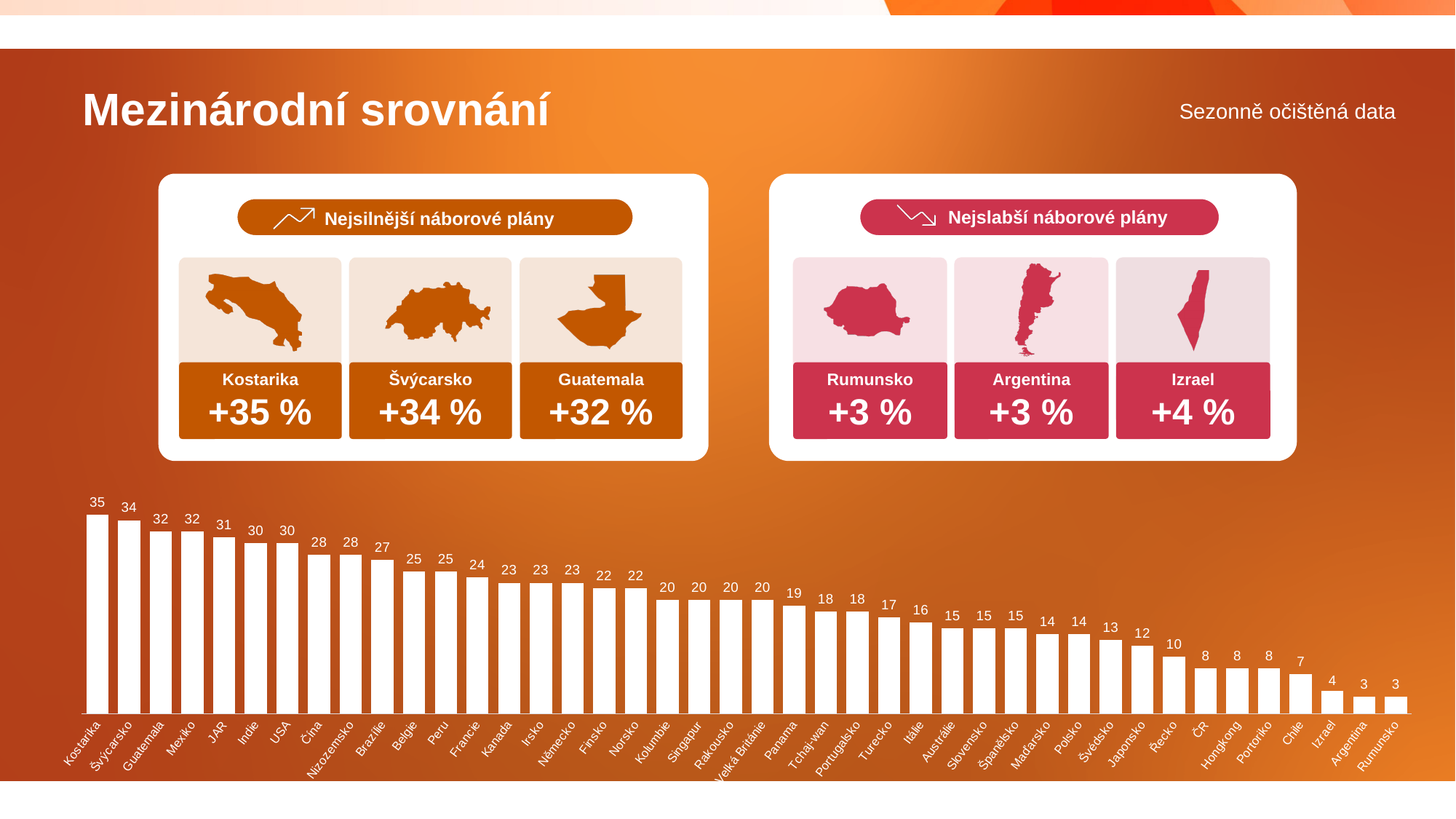
How many countries are shown in the bar chart? 42 What is the value for Německo in the bar chart? 23 Do the values in the bar chart rise or fall from left to right? Fall What is the value for Kostarika in the bar chart? 35 Which country has the highest value in the bar chart? Kostarika Which has a larger value in the bar chart, Indie or Francie? Indie What is the difference between the values for Brazílie and Polsko in the bar chart? 13 What is the value for Japonsko in the bar chart? 12 What is the value for ČR in the bar chart? 8 What kind of chart is shown at the bottom of the slide? Bar chart What is the difference between the values for Kostarika and Rumunsko in the bar chart? 32 Which has a larger value in the bar chart, Chile or Turecko? Turecko